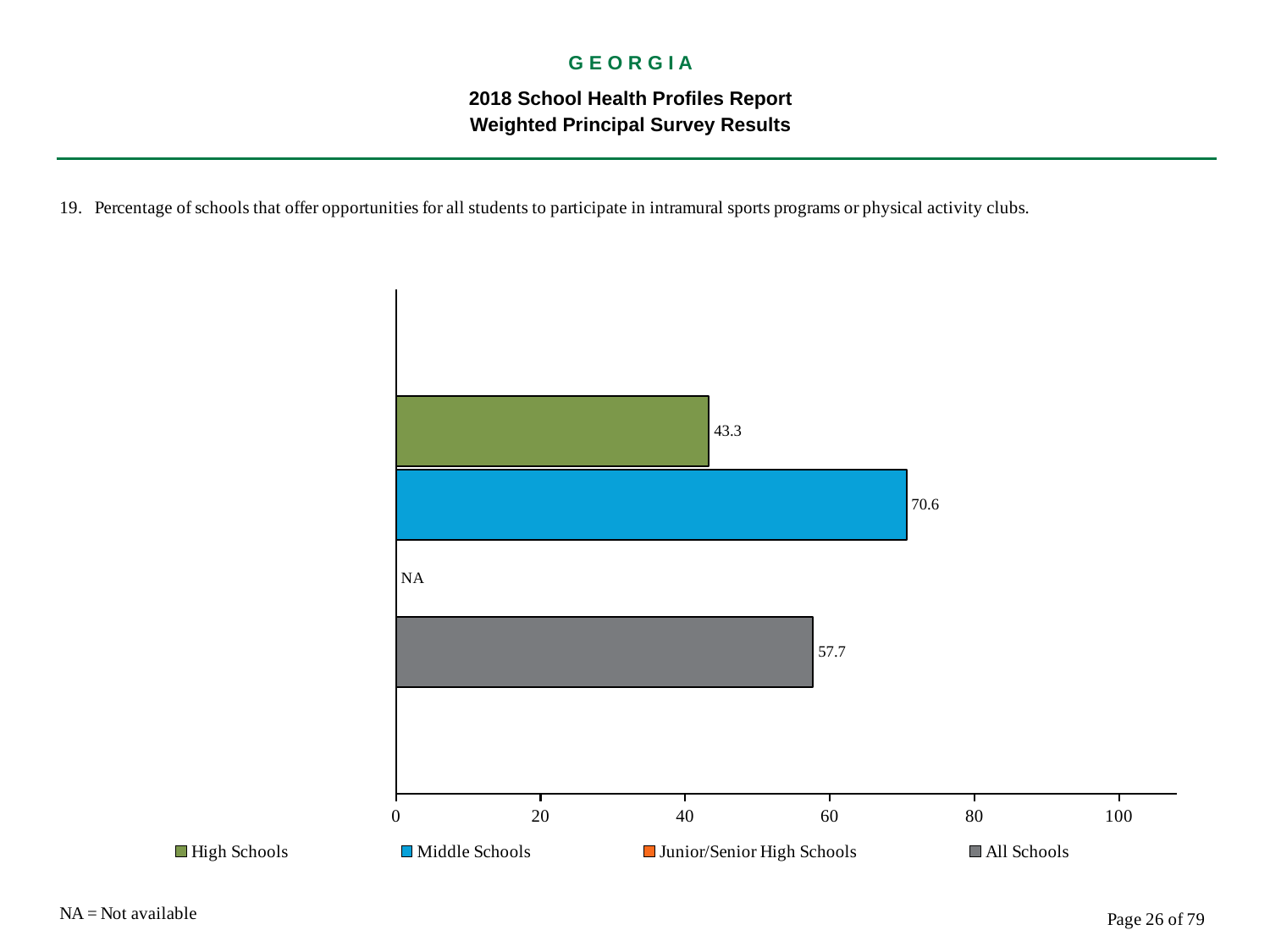
What is the value for All Schools? 57.7 What kind of chart is shown on the slide? bar chart Which school type with a plotted value has the lowest value? High Schools What does NA stand for according to the note on the slide? Not available How many series does the legend list? 4 What is shown for Junior/Senior High Schools? NA Is the value for Middle Schools greater or less than 60? greater Which is larger, the value for All Schools or the value for High Schools? All Schools Which school type has the highest value? Middle Schools What is the value for Middle Schools? 70.6 What is the difference between the Middle Schools value and the High Schools value? 27.3 What is the value for High Schools? 43.3